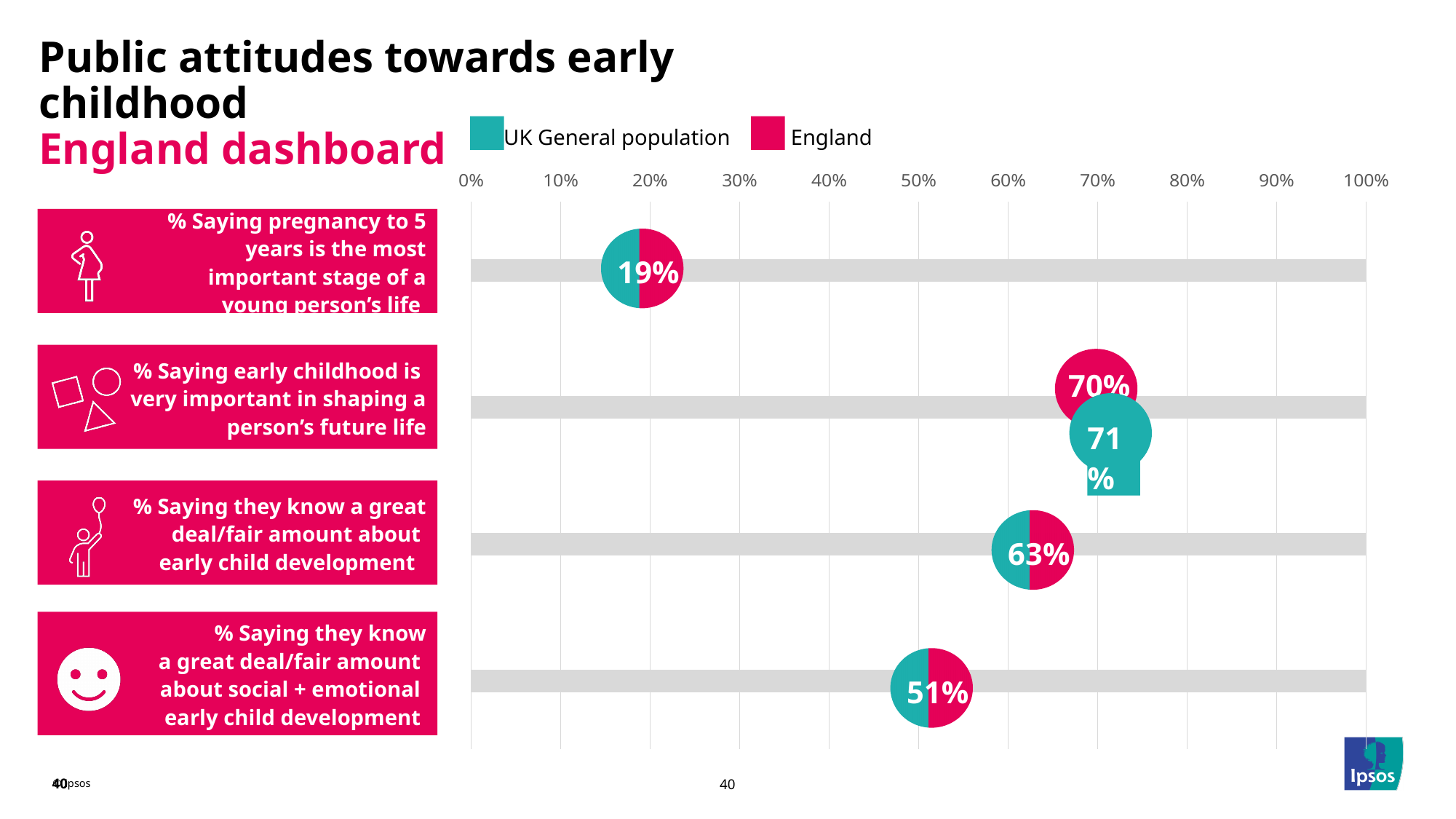
Which statement has the lowest percentage on the chart? % Saying pregnancy to 5 years is the most important stage of a young person's life What percentage say they know a great deal/fair amount about social + emotional early child development? 51% What percentage say they know a great deal/fair amount about early child development? 63% How many statements (categories) are plotted on the chart? 4 What percentage say pregnancy to 5 years is the most important stage of a young person's life? 19% For the statement that early childhood is very important in shaping a person's future life, what is the difference between the UK General population and England values? 1 percentage point Which statement has the highest percentage on the chart? % Saying early childhood is very important in shaping a person's future life What is the England value for the percentage saying early childhood is very important in shaping a person's future life? 70% How many series does the legend list? 2 What is the difference between the percentage who know a great deal/fair amount about early child development and the percentage who know a great deal/fair amount about social + emotional early child development? 12 percentage points Which is larger: the percentage who know a great deal/fair amount about early child development, or the percentage who know a great deal/fair amount about social + emotional early child development? Early child development What is the UK General population value for the percentage saying early childhood is very important in shaping a person's future life? 71%